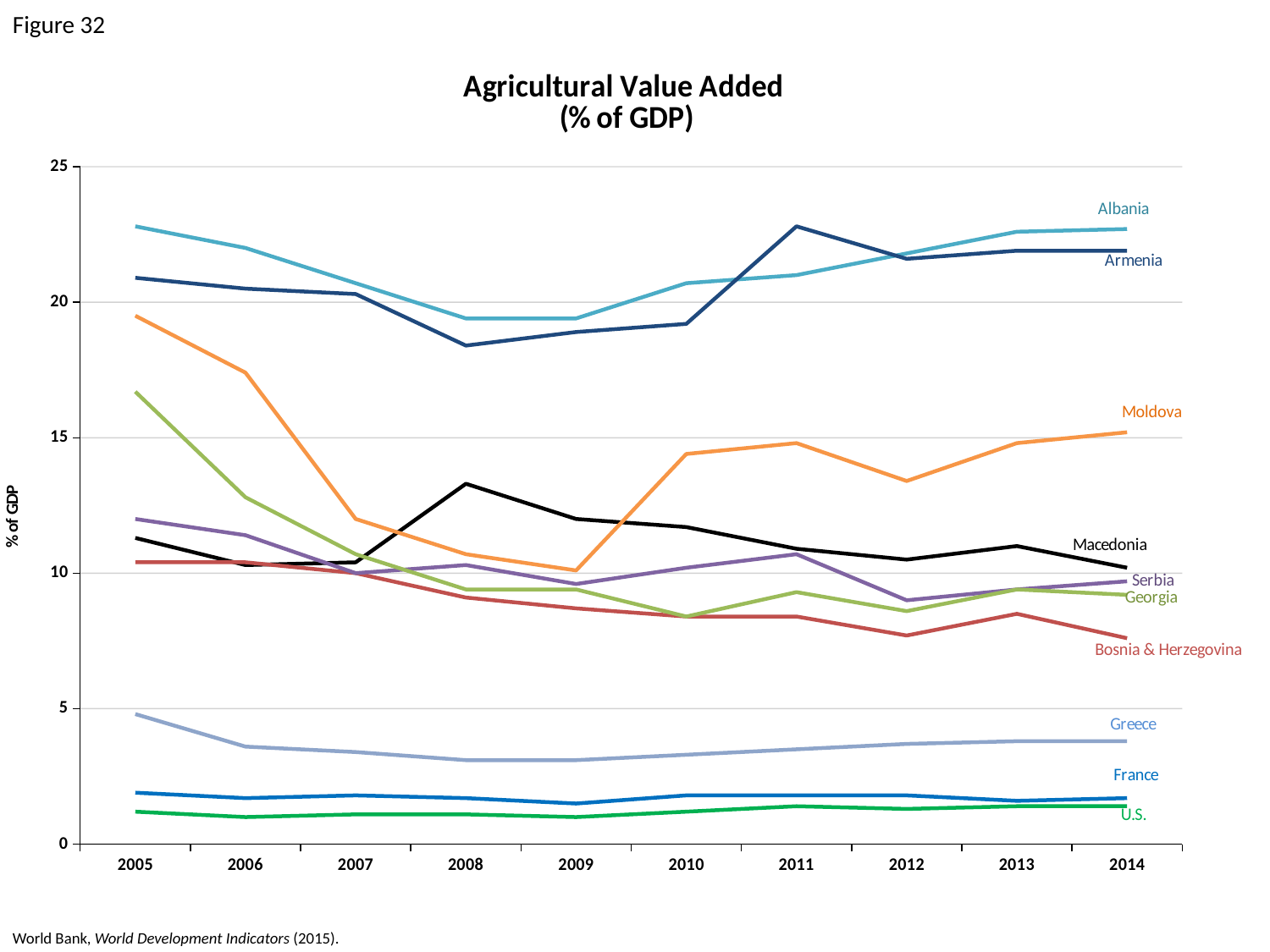
Does the value for Moldova rise or fall from 2005 to 2009? fall How many years are shown along the x axis of the chart? 10 Which country has the highest value in 2011? Armenia What is the label on the y axis of the chart? % of GDP Is the value for Macedonia in 2008 greater or less than 10? greater In 2005, which is larger: the value for Moldova or the value for Georgia? Moldova Which country has the highest agricultural value added in 2005? Albania Is the value for Moldova in 2005 greater or less than 15? greater Is the value for Greece in 2014 greater or less than 5? less What kind of chart is shown on the slide? line chart How many countries are plotted as lines in the chart? 10 Which country has the lowest agricultural value added in 2014? U.S.